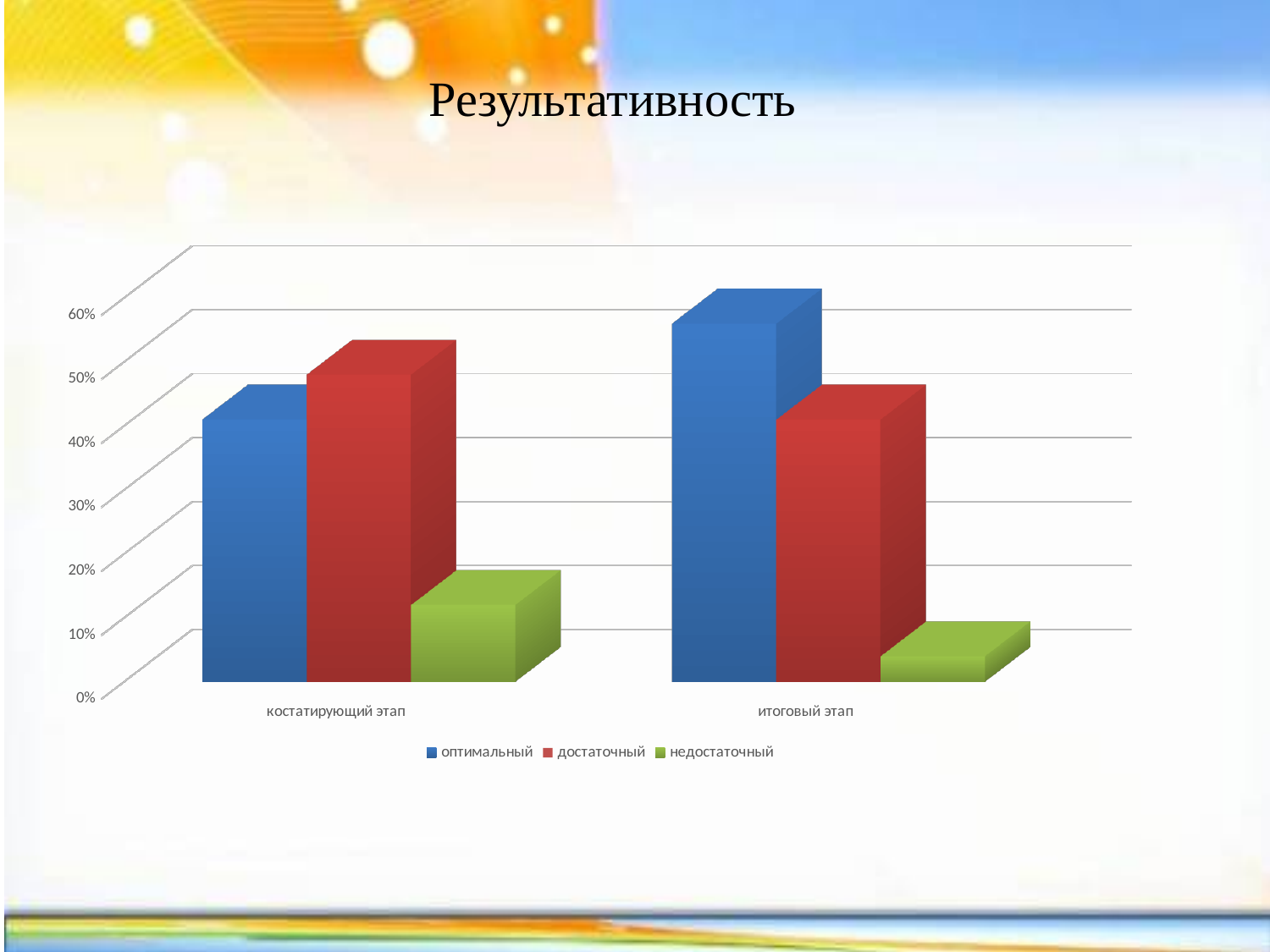
Is the value for недостаточный at итоговый этап greater or less than 10%? less How many categories are shown on the x axis? 2 Which series has the highest value for итоговый этап? оптимальный For костатирующий этап, which is larger: оптимальный or достаточный? достаточный Which colour represents the series недостаточный in the legend? green What is the title of the slide with the chart? Результативность Is the value for оптимальный at итоговый этап greater or less than 50%? greater How many series does the legend list? 3 What kind of chart is shown on the slide? bar chart Does the value for оптимальный rise or fall from костатирующий этап to итоговый этап? rise Which series has the lowest value for итоговый этап? недостаточный Which series has the highest value for костатирующий этап? достаточный